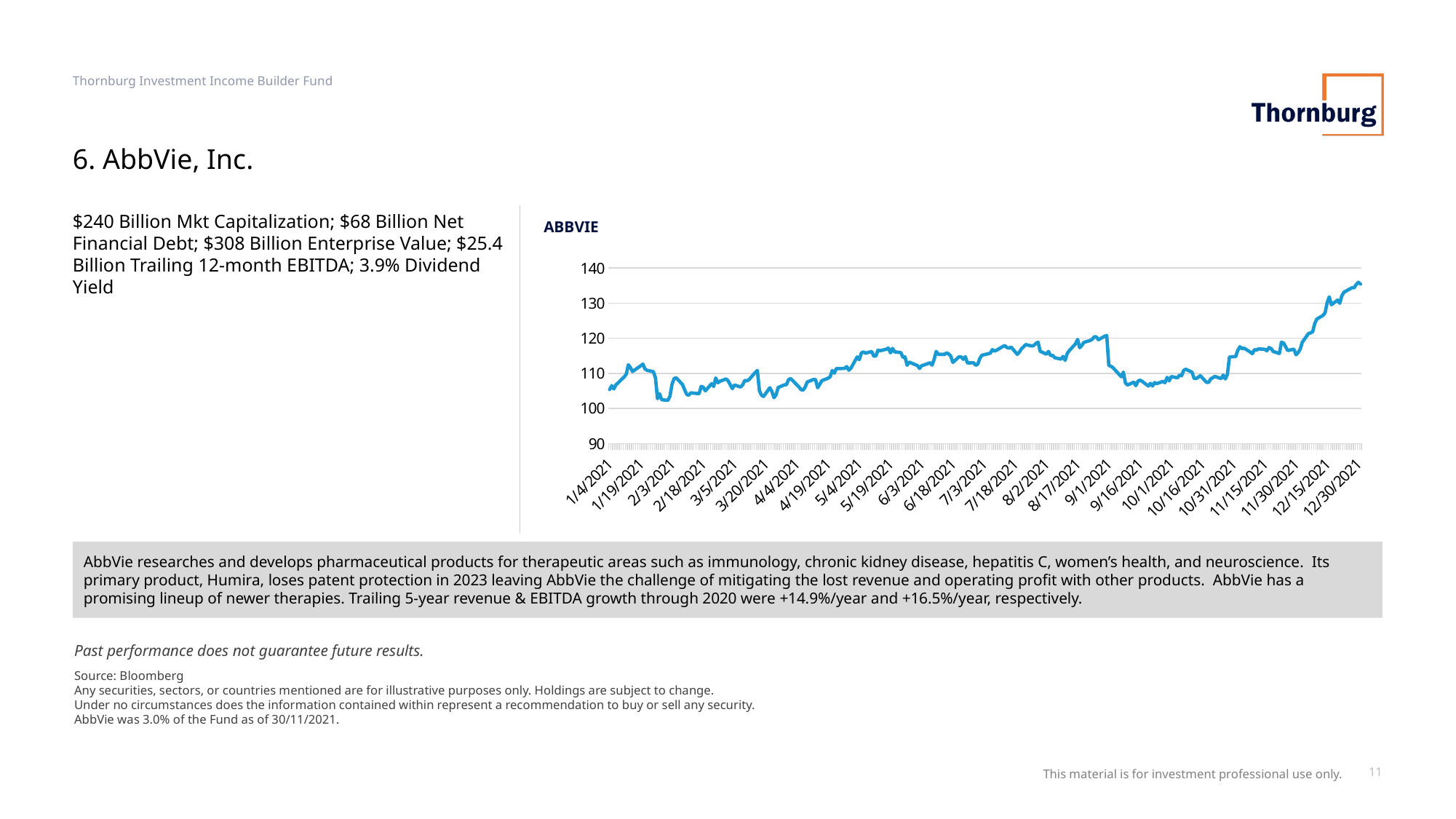
Is the value at 12/30/2021 greater or less than 140? less Is the value at 9/16/2021 greater or less than 110? less Is the value at 1/4/2021 greater or less than 110? less How many data series are plotted in the chart? 1 Which is higher, the value at 8/17/2021 or the value at 9/16/2021? 8/17/2021 Which is higher, the value at 12/30/2021 or the value at 1/4/2021? 12/30/2021 What kind of chart is shown on the slide? line chart Overall, does the plotted value rise or fall from 1/4/2021 to 12/30/2021? rise What is the title of the chart? ABBVIE What is the lowest value shown on the vertical axis? 90